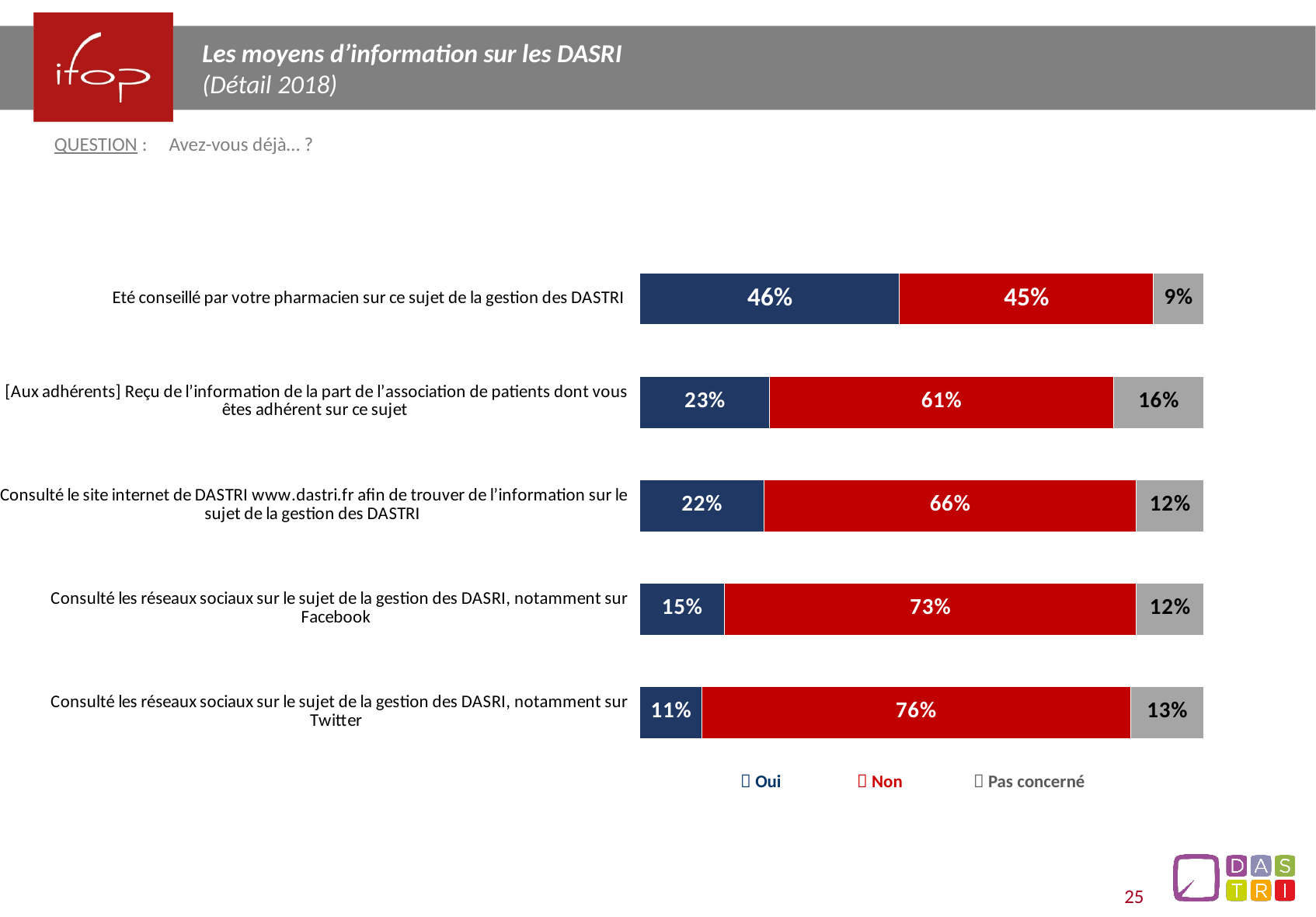
Which item has the highest "Oui" percentage? Eté conseillé par votre pharmacien sur ce sujet de la gestion des DASTRI Which colour represents "Non" in the chart? Red What is the total of the stacked bar for "Consulté le site internet de DASTRI www.dastri.fr afin de trouver de l'information sur le sujet de la gestion des DASTRI"? 100% What type of chart is shown on the slide? Stacked bar chart Is the "Oui" value larger for the DASTRI website item or for the Facebook item? DASTRI website item (22%) Which item has the lowest "Oui" percentage? Consulté les réseaux sociaux sur le sujet de la gestion des DASRI, notamment sur Twitter What is the "Pas concerné" value for "[Aux adhérents] Reçu de l'information de la part de l'association de patients dont vous êtes adhérent sur ce sujet"? 16% How many items (bars) are shown in the chart? 5 What is the "Non" value for "Consulté les réseaux sociaux sur le sujet de la gestion des DASRI, notamment sur Twitter"? 76% What is the difference between the "Non" values for the Twitter item and the Facebook item? 3% What percentage answered "Oui" for "Eté conseillé par votre pharmacien sur ce sujet de la gestion des DASTRI"? 46% How many series does the legend list? 3